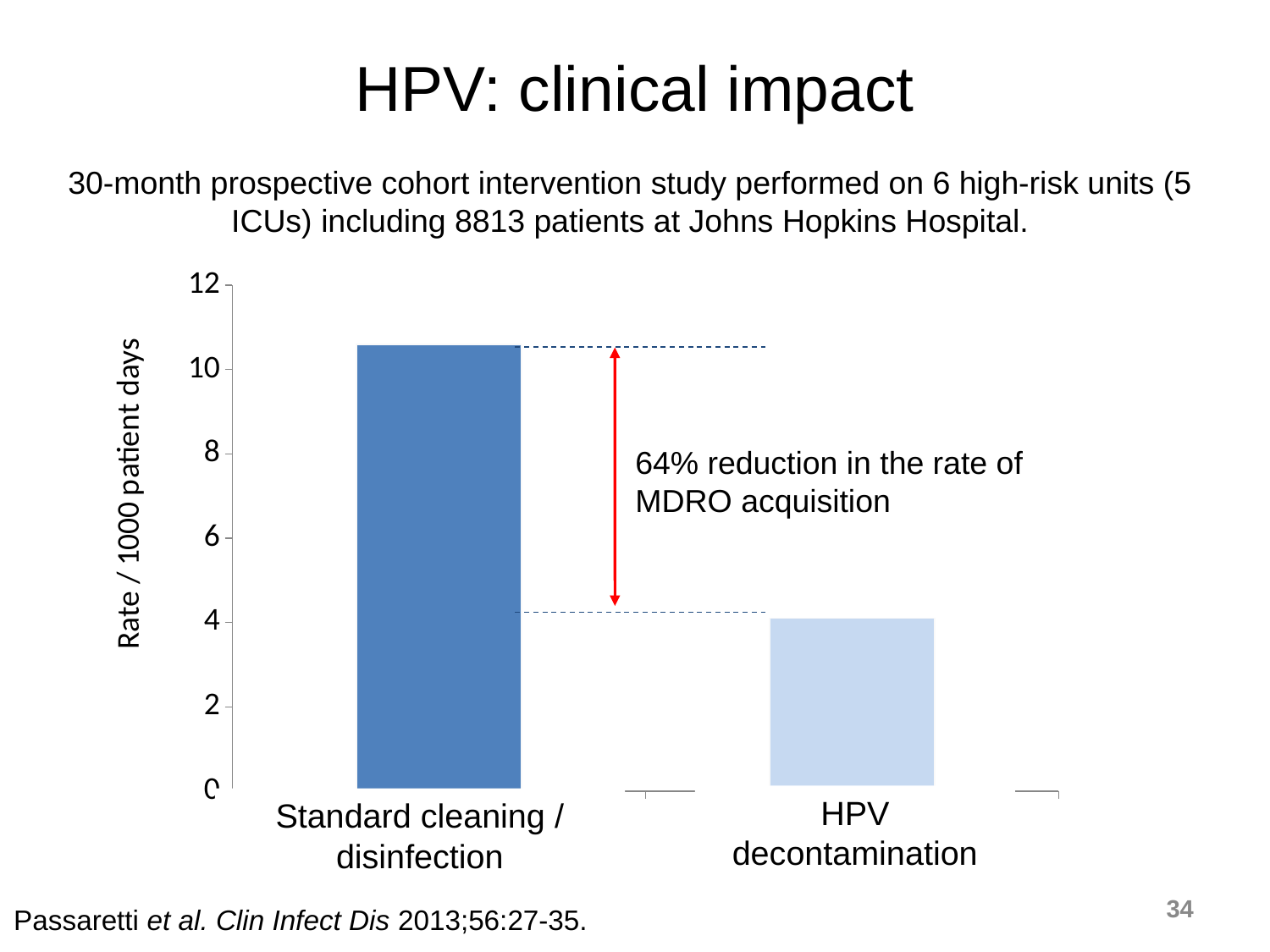
Is the value for Standard cleaning / disinfection greater or less than 8? greater Which is larger, the rate for Standard cleaning / disinfection or the rate for HPV decontamination? Standard cleaning / disinfection What kind of chart is shown on the slide? Bar chart Which category has the lowest rate per 1000 patient days? HPV decontamination Is the value for HPV decontamination greater or less than 6? less How many bars (categories) does the chart show? 2 Which category has the highest rate per 1000 patient days? Standard cleaning / disinfection Is the value for Standard cleaning / disinfection greater or less than 12? less What is the label of the vertical axis of the chart? Rate / 1000 patient days What reduction in the rate of MDRO acquisition does the annotation on the chart state? 64% reduction